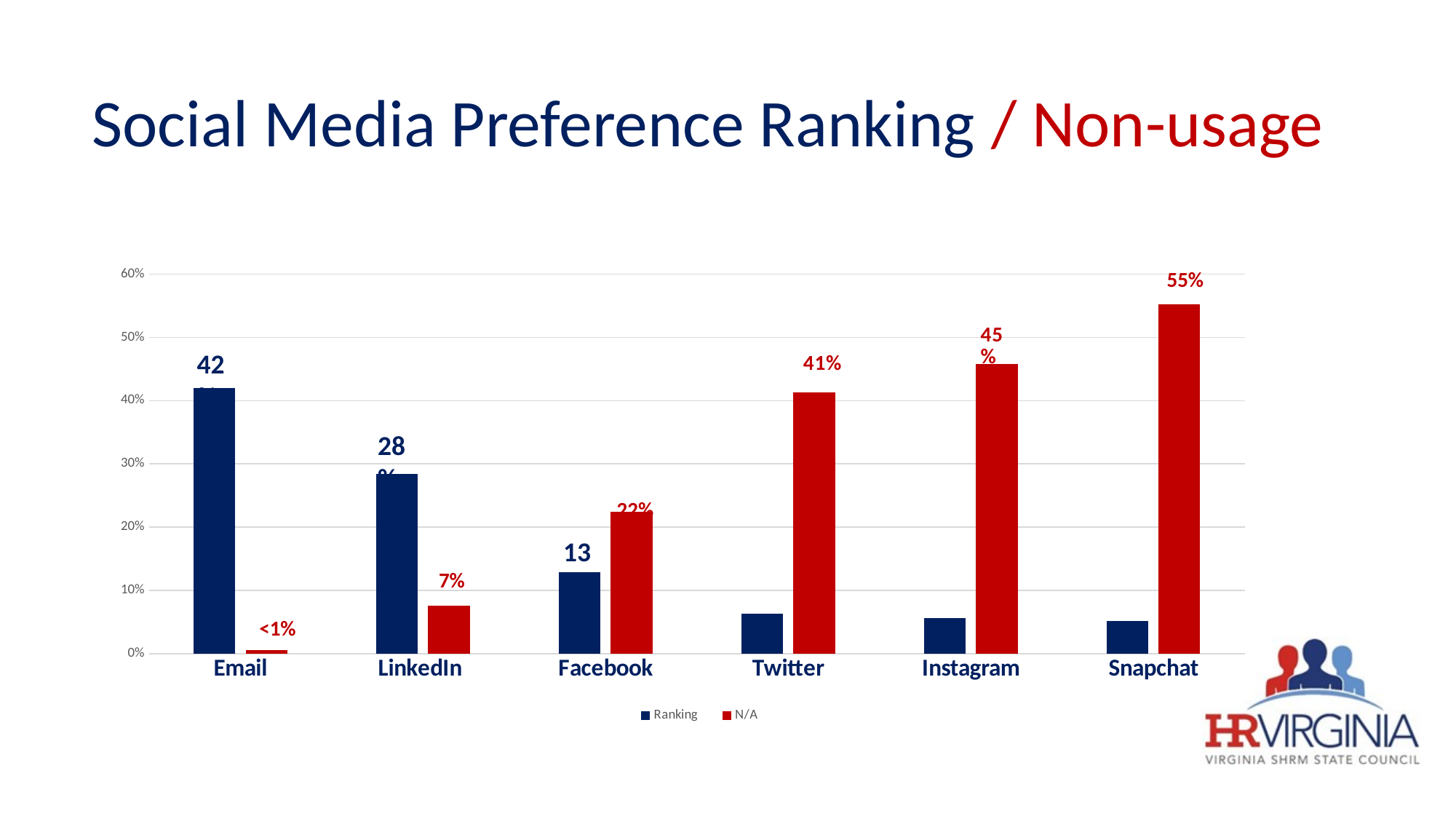
What is the N/A value for Twitter? 41% How many categories are shown on the x axis? 6 What is the N/A value for Email? <1% What is the N/A value for Snapchat? 55% Which category has the highest N/A value? Snapchat What kind of chart is shown on the slide? bar chart What is the N/A value for LinkedIn? 7% How many series does the legend list? 2 Which category has the highest Ranking value? Email What is the difference between the N/A values for Snapchat and Twitter? 14% Which has a larger N/A value, Instagram or Twitter? Instagram Is the Ranking value for Twitter greater or less than 10%? less